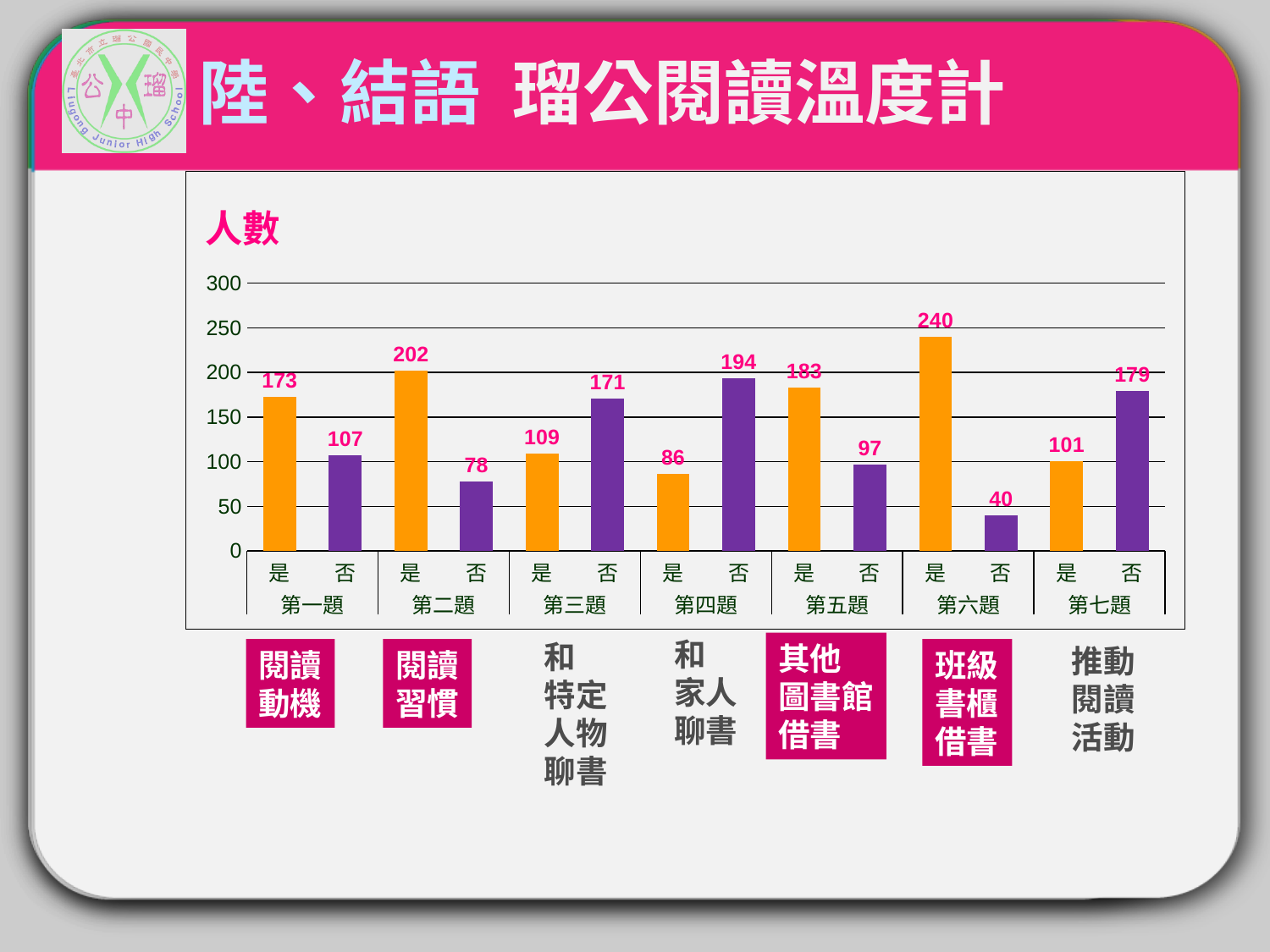
Which bar has the lowest value in the chart? 否 in 第六題 (40) How many questions (題) are shown on the x axis? 7 Is the value for 是 in 第五題 greater or less than 150? greater Which bar has the highest value in the chart? 是 in 第六題 (240) What is the value for 是 in 第一題? 173 What is the title shown above the chart? 人數 In 第三題, which is larger, 是 or 否? 否 What is the value for 否 in 第四題? 194 What is the difference between 是 and 否 in 第二題? 124 What is the total of 是 and 否 in 第七題? 280 What kind of chart is shown on the slide? bar chart What is the value for 否 in 第六題? 40